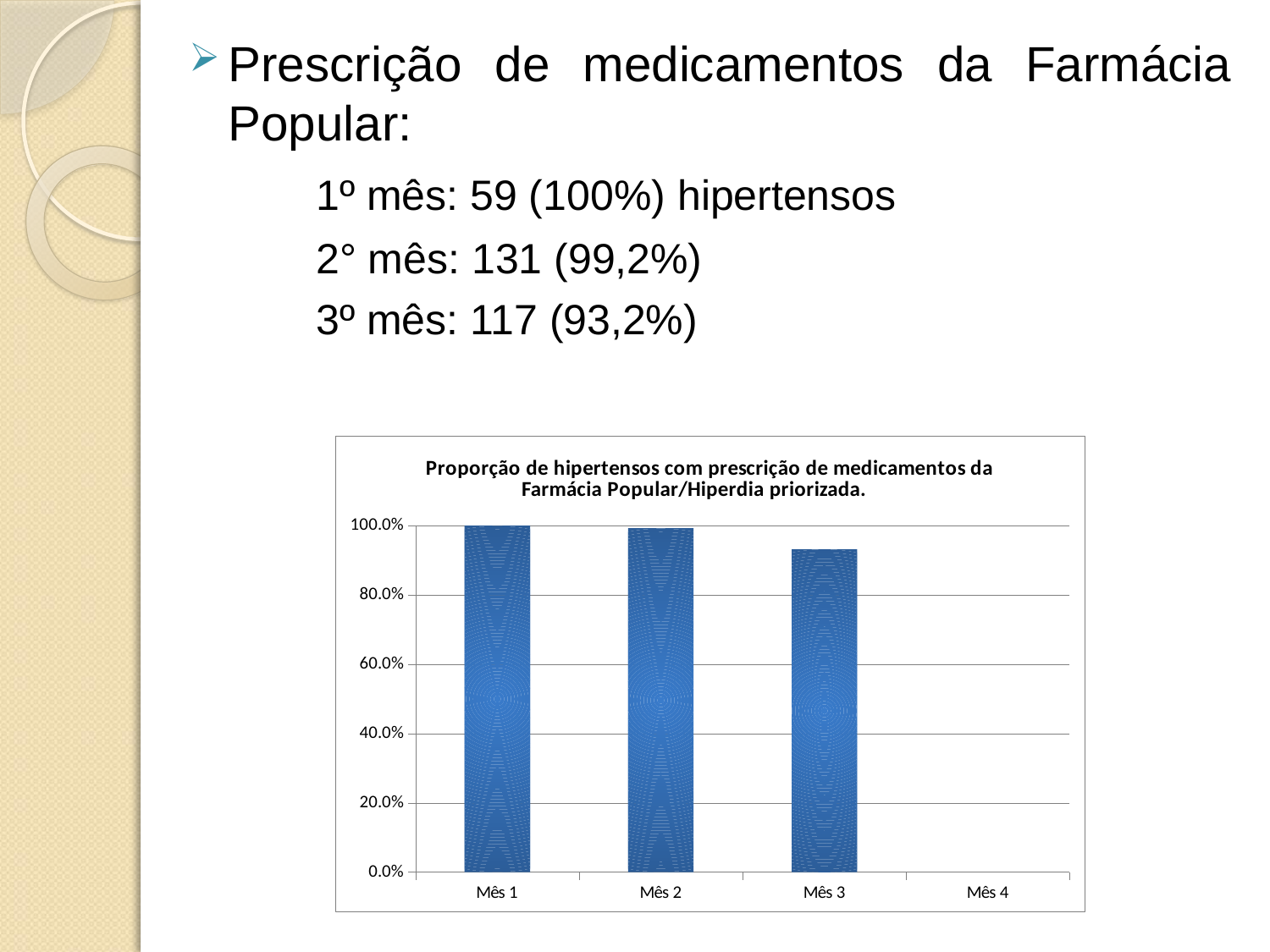
What is the title of the chart? Proporção de hipertensos com prescrição de medicamentos da Farmácia Popular/Hiperdia priorizada. Which category on the x axis has no bar plotted? Mês 4 Which is larger, the value for Mês 1 or the value for Mês 3? Mês 1 Do the values rise or fall from Mês 1 to Mês 3? Fall Is the value for Mês 3 greater or less than 80.0%? greater Is the value for Mês 2 greater or less than 80.0%? greater What is the value for Mês 1 in the chart? 100.0% Is the value for Mês 3 greater or less than 100.0%? less Which is larger, the value for Mês 2 or the value for Mês 3? Mês 2 Among Mês 1, Mês 2 and Mês 3, which has the lowest value? Mês 3 What type of chart is shown on the slide? Bar chart How many categories are shown on the x axis of the chart? 4